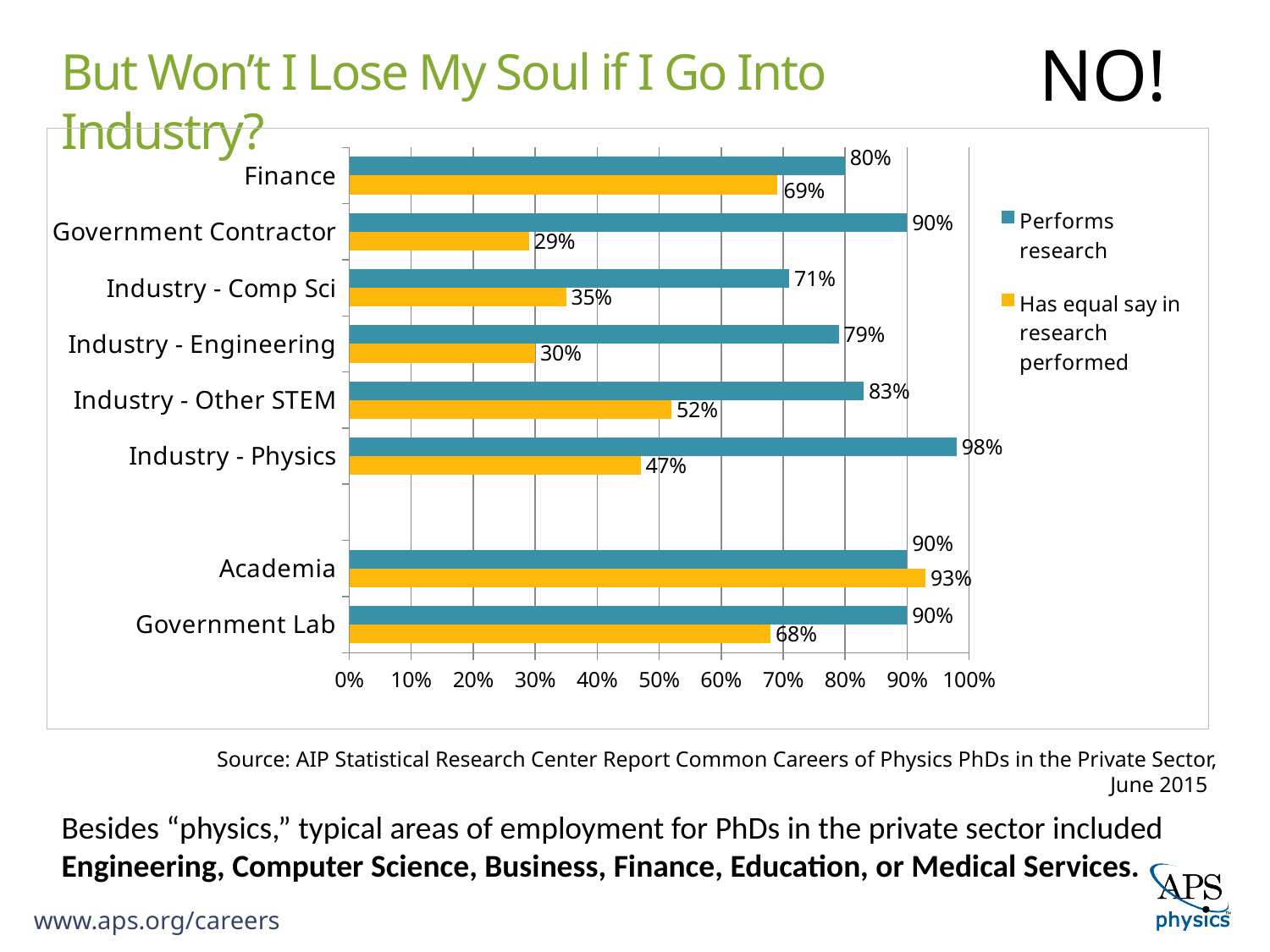
What is the difference between the 'Performs research' and 'Has equal say in research performed' values for Industry - Engineering? 49% Which category has the highest 'Performs research' value? Industry - Physics What kind of chart is shown on the slide? Bar chart What percentage of Industry - Physics respondents perform research? 98% What is the 'Performs research' value for Industry - Comp Sci? 71% How many series does the legend list? 2 Is the 'Has equal say in research performed' value for Finance greater or less than 60%? greater What is the value for 'Has equal say in research performed' for Government Contractor? 29% How many labeled categories are shown on the chart? 8 Which category has the lowest 'Has equal say in research performed' value? Government Contractor Which colour represents the 'Performs research' series? Blue Which is larger for Academia: 'Performs research' or 'Has equal say in research performed'? Has equal say in research performed